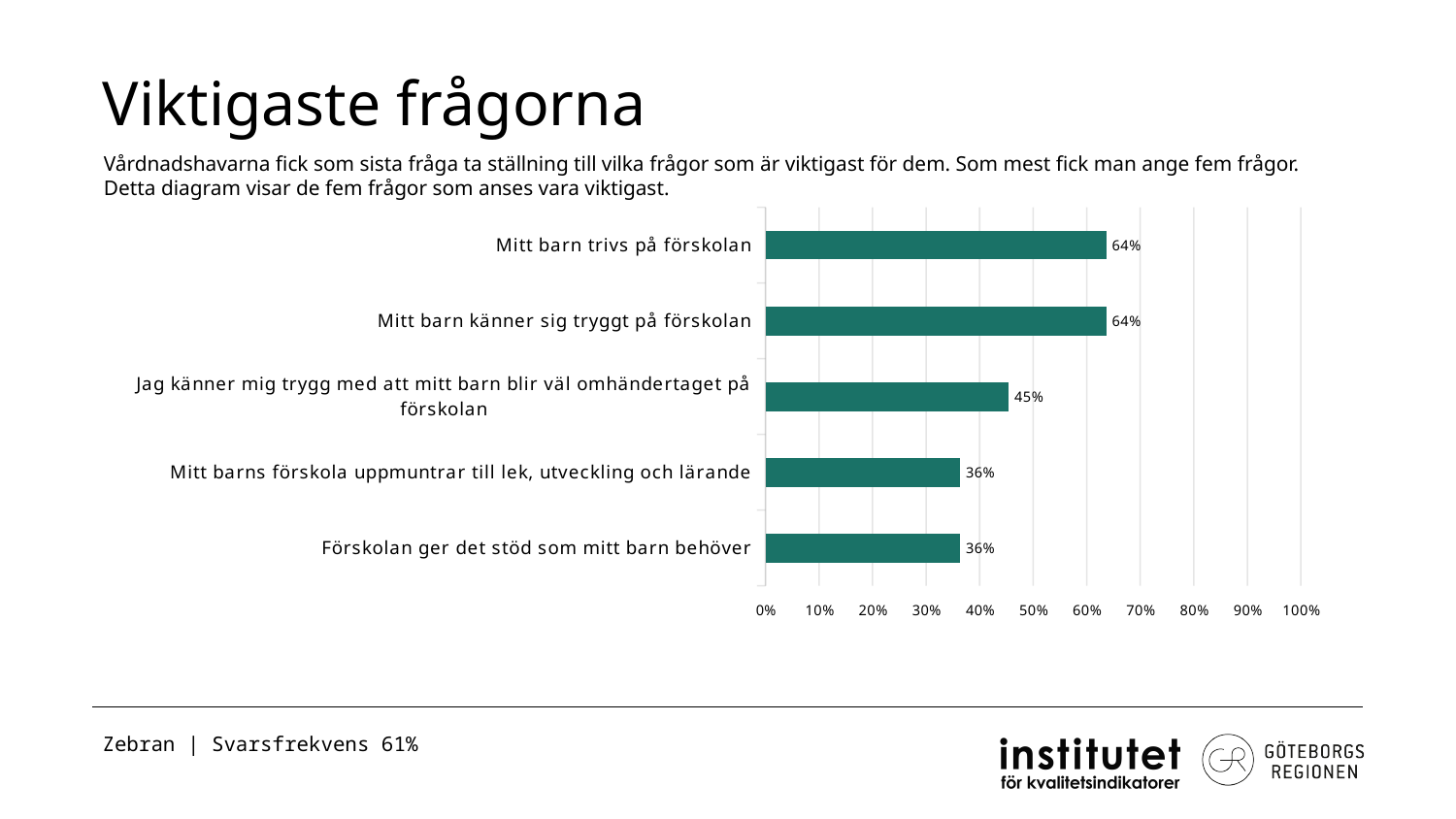
What is the title of the slide? Viktigaste frågorna What value is shown for "Mitt barn trivs på förskolan"? 64% What is the lowest value shown in the chart? 36% What is the difference between the value for "Mitt barn känner sig tryggt på förskolan" and the value for "Jag känner mig trygg med att mitt barn blir väl omhändertaget på förskolan"? 19 percentage points Which has a larger value: "Jag känner mig trygg med att mitt barn blir väl omhändertaget på förskolan" or "Förskolan ger det stöd som mitt barn behöver"? Jag känner mig trygg med att mitt barn blir väl omhändertaget på förskolan What is the highest value shown in the chart? 64% What value is shown for "Jag känner mig trygg med att mitt barn blir väl omhändertaget på förskolan"? 45% What value is shown for "Förskolan ger det stöd som mitt barn behöver"? 36% How many categories are shown in the chart? 5 What value is shown for "Mitt barns förskola uppmuntrar till lek, utveckling och lärande"? 36% Is the value for "Jag känner mig trygg med att mitt barn blir väl omhändertaget på förskolan" greater or less than 40%? greater What kind of chart is shown on the slide? bar chart